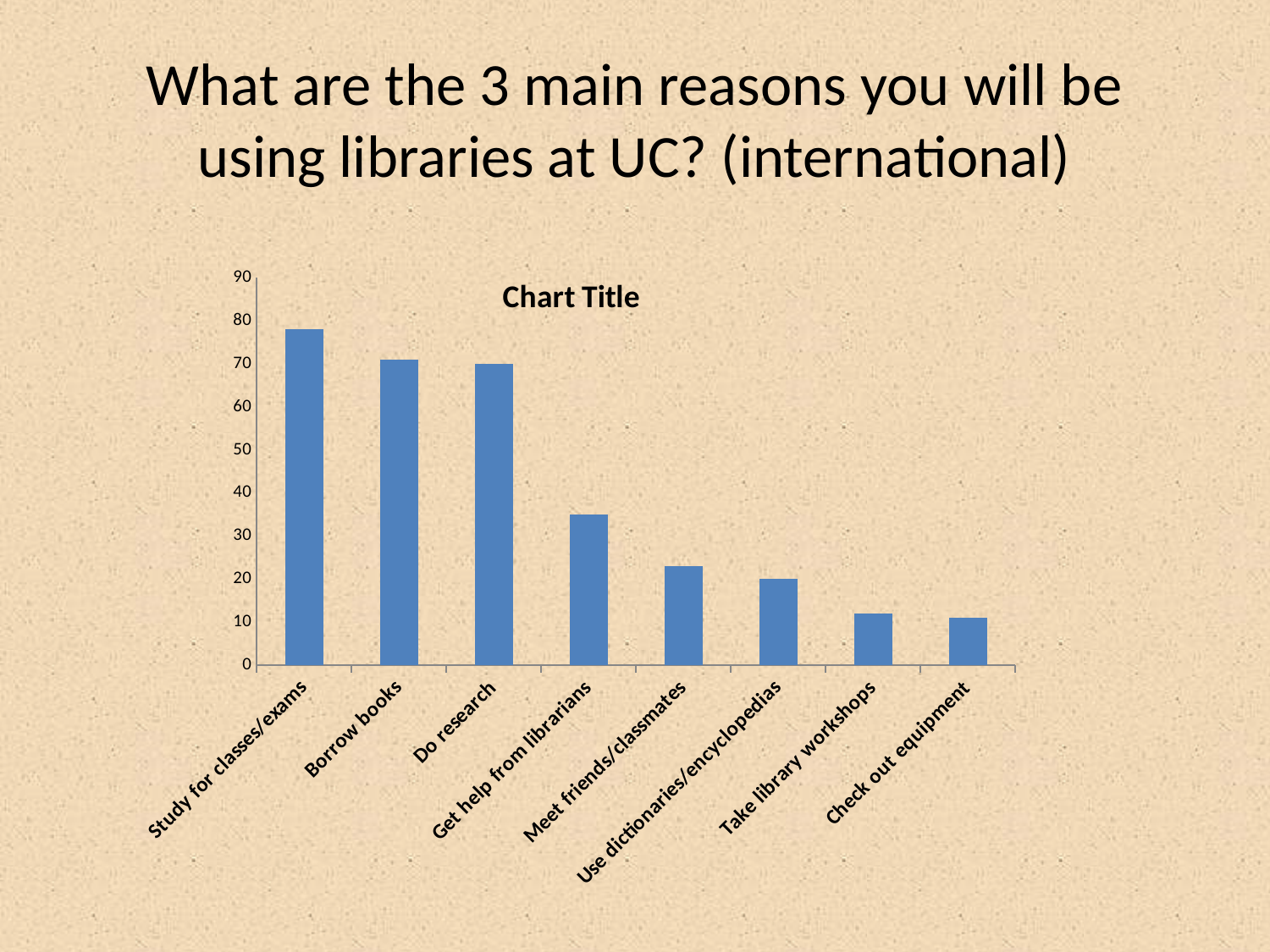
Is the value for Meet friends/classmates greater or less than 30? less Which category has the highest value in the chart? Study for classes/exams Is the value for Study for classes/exams greater or less than 70? greater Do the values rise or fall moving from left to right along the x axis? fall What kind of chart is shown on the slide? bar chart What is the title printed inside the chart area? Chart Title Is the value for Get help from librarians greater or less than 30? greater How many categories are shown on the x axis of the chart? 8 Which is larger, the value for Get help from librarians or the value for Meet friends/classmates? Get help from librarians